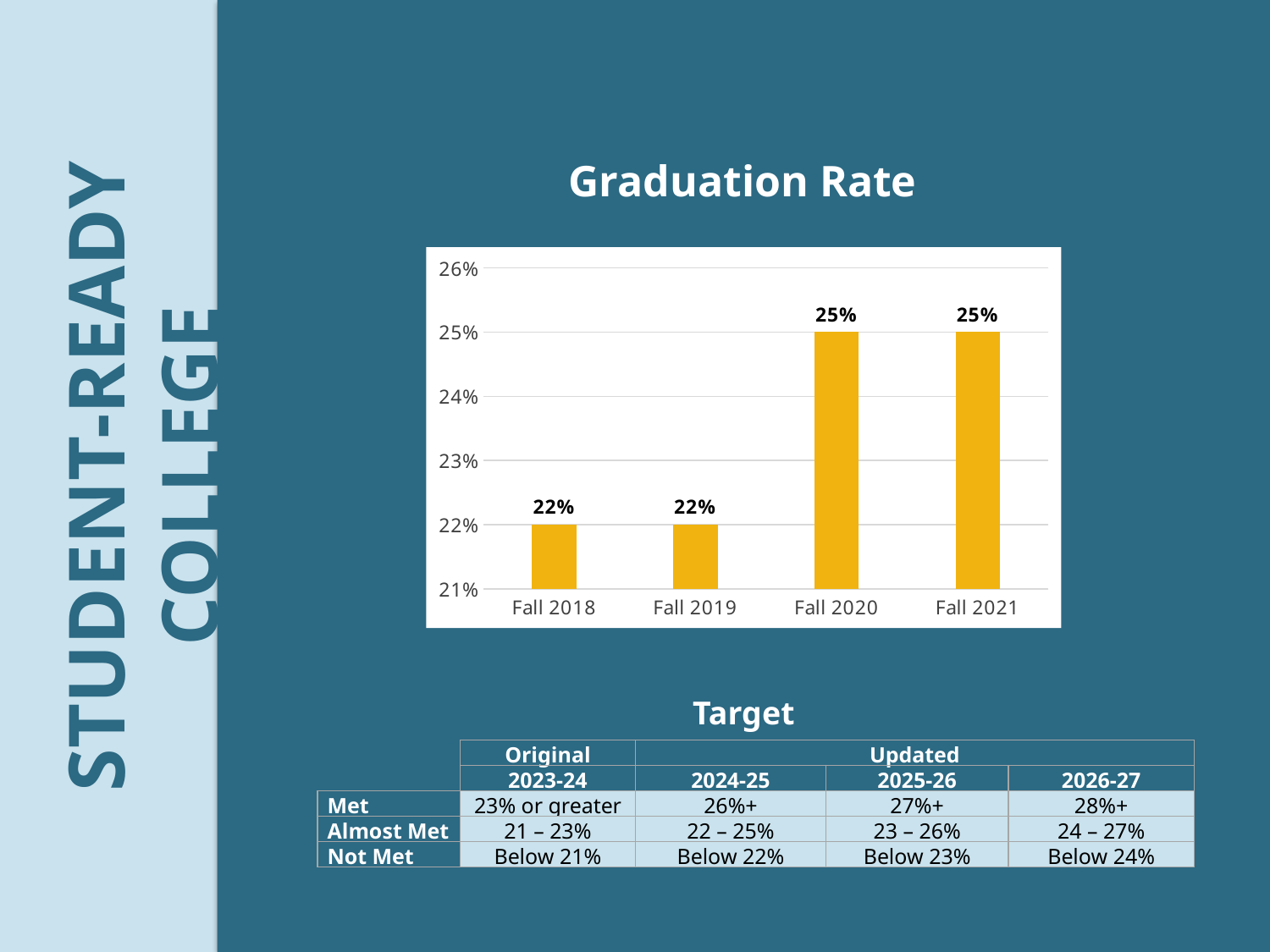
Is the graduation rate for Fall 2019 greater or less than 23%? less What is the graduation rate for Fall 2020? 25% What is the title of the chart? Graduation Rate Does the graduation rate rise or fall from Fall 2018 to Fall 2021? rise Which is larger, the graduation rate for Fall 2018 or for Fall 2021? Fall 2021 What is the difference between the graduation rate in Fall 2020 and Fall 2019? 3% How many terms are shown on the x axis of the chart? 4 What is the graduation rate for Fall 2018? 22% What is the graduation rate for Fall 2019? 22% What is the graduation rate for Fall 2021? 25% What kind of chart is used to show the graduation rate? bar chart Is the graduation rate for Fall 2020 greater or less than 24%? greater